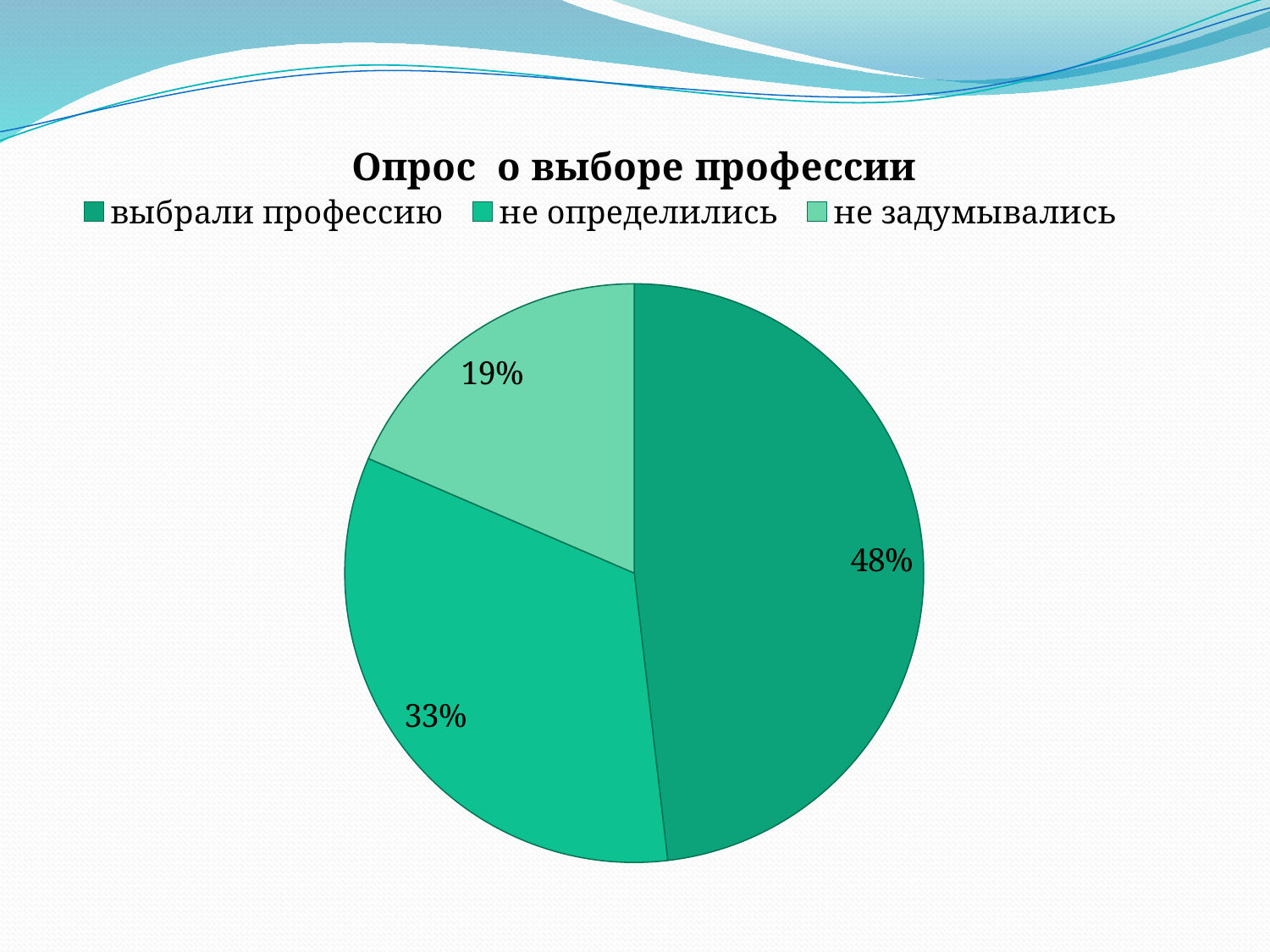
What share of the pie is labelled "не задумывались"? 19% What is the difference in percentage points between "выбрали профессию" and "не определились"? 15% How many entries does the legend list? 3 What share of the pie is labelled "выбрали профессию"? 48% What share of the pie is labelled "не определились"? 33% Which category has the largest slice of the pie? выбрали профессию Which category has the smallest slice of the pie? не задумывались Which is larger: the share for "не определились" or the share for "не задумывались"? не определились What type of chart is shown on the slide? pie chart How many slices does the pie chart have? 3 What is the difference in percentage points between "не определились" and "не задумывались"? 14% What is the title of the chart? Опрос о выборе профессии